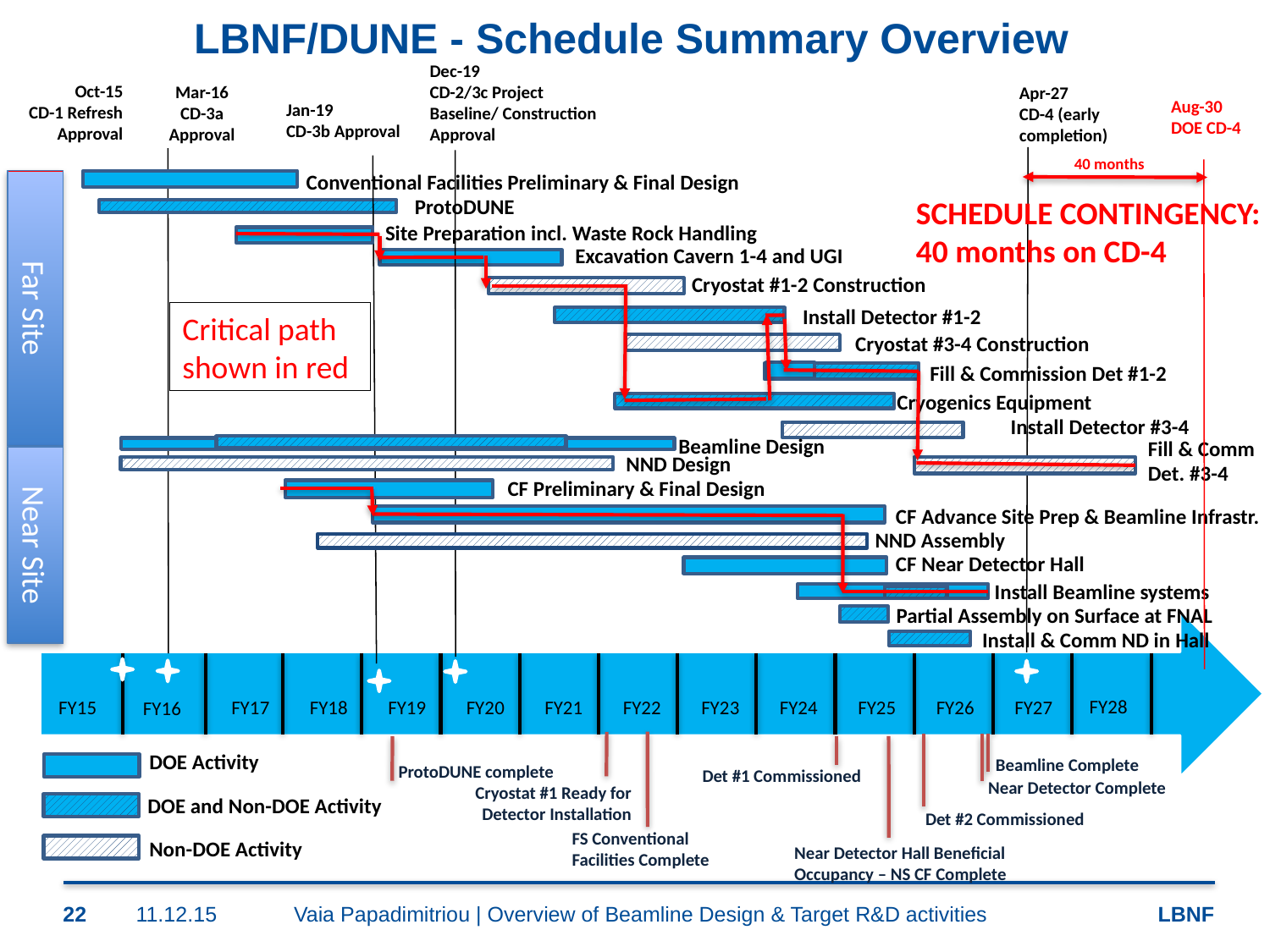
What is the date of the DOE CD-4 milestone? Aug-30 How many activity types does the legend list? 3 What is the date of the CD-1 Refresh Approval milestone? Oct-15 What kind of chart is shown on the slide? Gantt chart What is the date of the CD-3b Approval milestone? Jan-19 In what colour is the critical path shown on the chart? Red What is the date of the CD-4 (early completion) milestone? Apr-27 What is the date of the CD-2/3c Project Baseline/Construction Approval milestone? Dec-19 How much schedule contingency is shown on CD-4? 40 months How many fiscal years are marked along the timeline at the bottom of the chart? 14 What is the date of the CD-3a Approval milestone? Mar-16 Into which two site groups are the activities on the chart divided? Far Site and Near Site